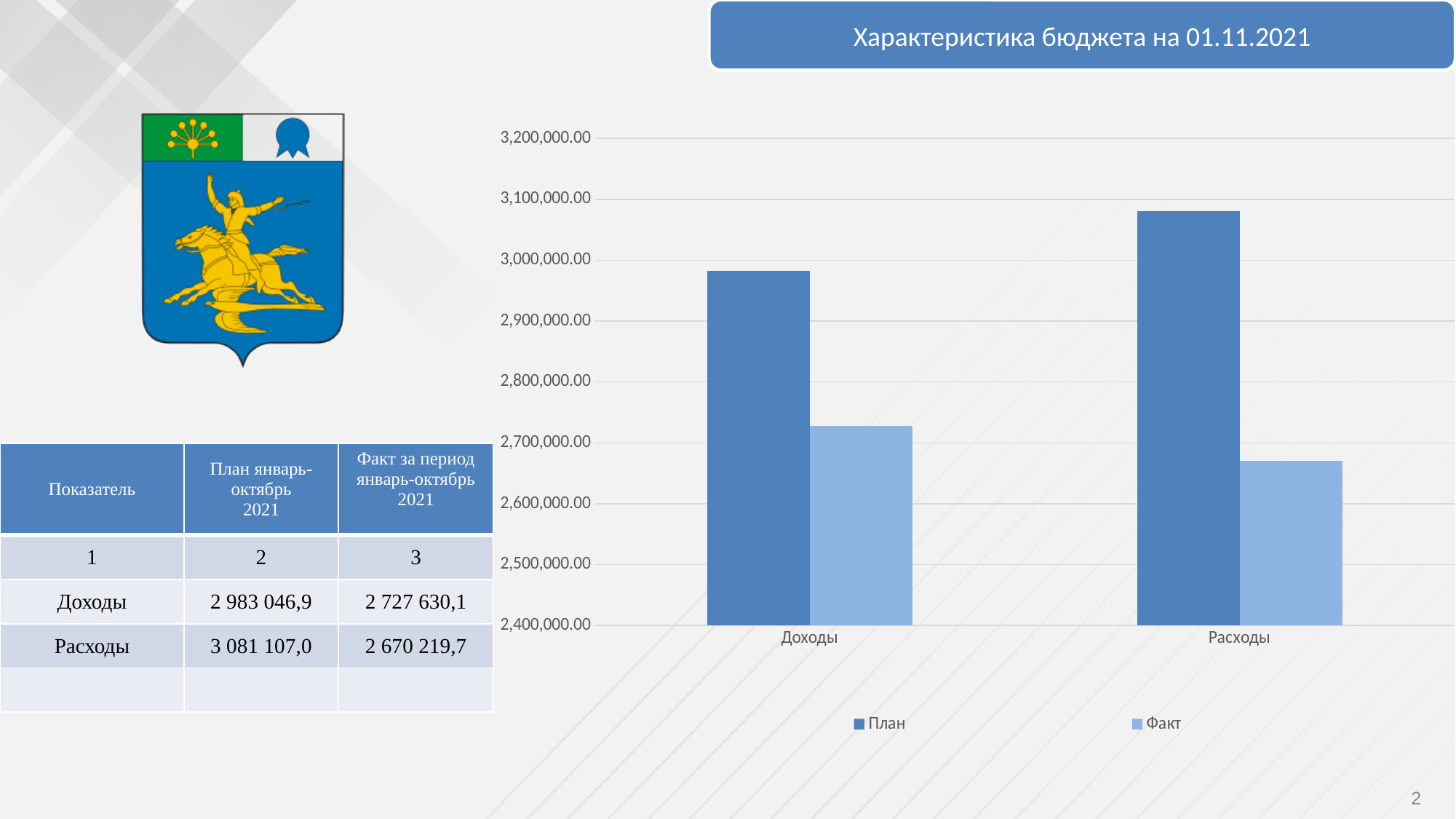
How many categories are shown on the x axis of the chart? 2 What is the title shown above the chart? Характеристика бюджета на 01.11.2021 What kind of chart is shown on the slide? bar chart Which is larger, the Факт value for Доходы or the Факт value for Расходы? Доходы Is the План value for Расходы greater or less than 3,000,000.00? greater Which bar in the chart is the shortest? Факт for Расходы Is the Факт value for Доходы greater or less than 2,700,000.00? greater Is the План value for Доходы greater or less than 3,000,000.00? less Which bar in the chart is the tallest? План for Расходы What are the two series named in the chart legend? План and Факт How many series does the chart legend list? 2